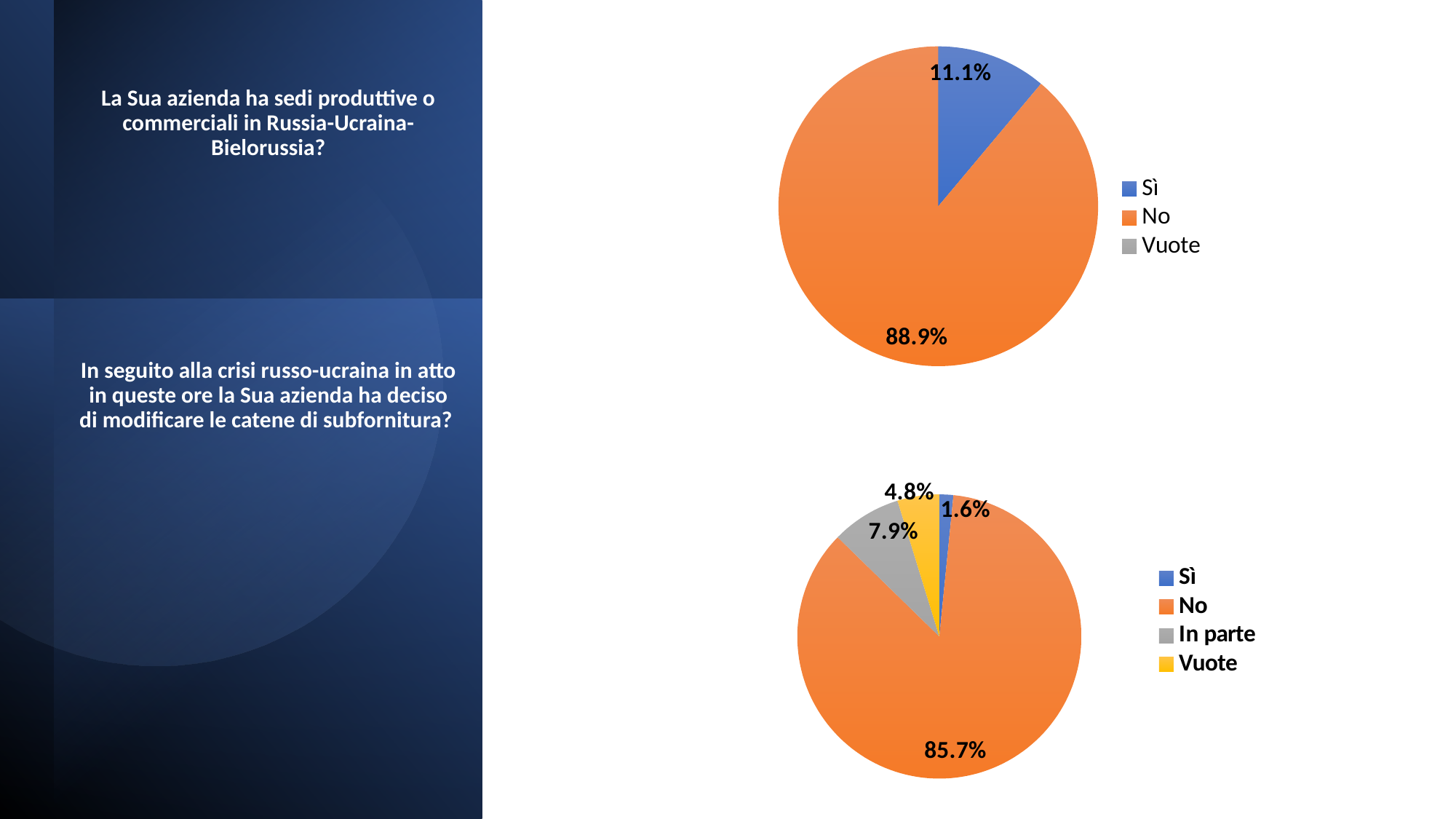
What type of chart is used for the top chart on the slide? Pie chart In the bottom pie chart, what share is labelled for "Vuote"? 4.8% In the bottom pie chart, which is larger: the "In parte" slice or the "Vuote" slice? In parte In the bottom pie chart, what share of respondents answered "Sì"? 1.6% How many entries does the legend of the bottom pie chart list? 4 How many entries does the legend of the top pie chart list? 3 In the bottom pie chart, what share of respondents answered "In parte"? 7.9% In the top pie chart, what is the difference between the "No" and "Sì" shares? 77.8% In the bottom pie chart, which category has the largest slice? No In the bottom pie chart, which category has the smallest slice? Sì In the top pie chart, what share of respondents answered "Sì"? 11.1% In the top pie chart, what share of respondents answered "No"? 88.9%